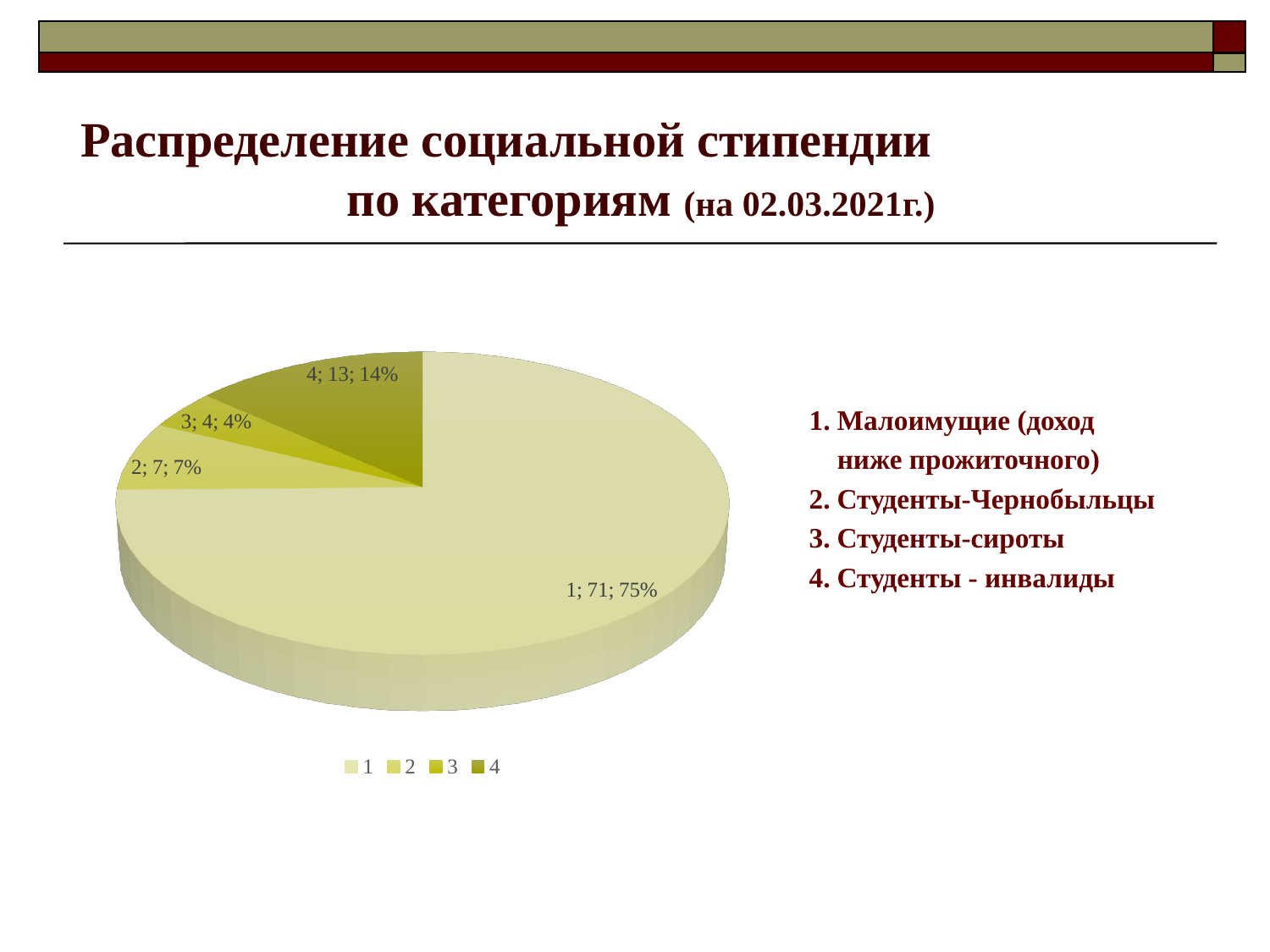
What is the value for category 4 in the pie chart? 13 Which category has the largest slice in the pie chart? 1 What is the value for category 1 in the pie chart? 71 What is the value for category 2 in the pie chart? 7 Which category has the smallest slice in the pie chart? 3 What kind of chart is shown on the slide? pie chart What percentage share does category 3 have in the pie chart? 4% How many slices does the pie chart have? 4 How many entries does the legend list? 4 Which is larger, the value for category 2 or category 4? category 4 What percentage share does category 1 have in the pie chart? 75% What is the difference between the values for category 1 and category 4? 58